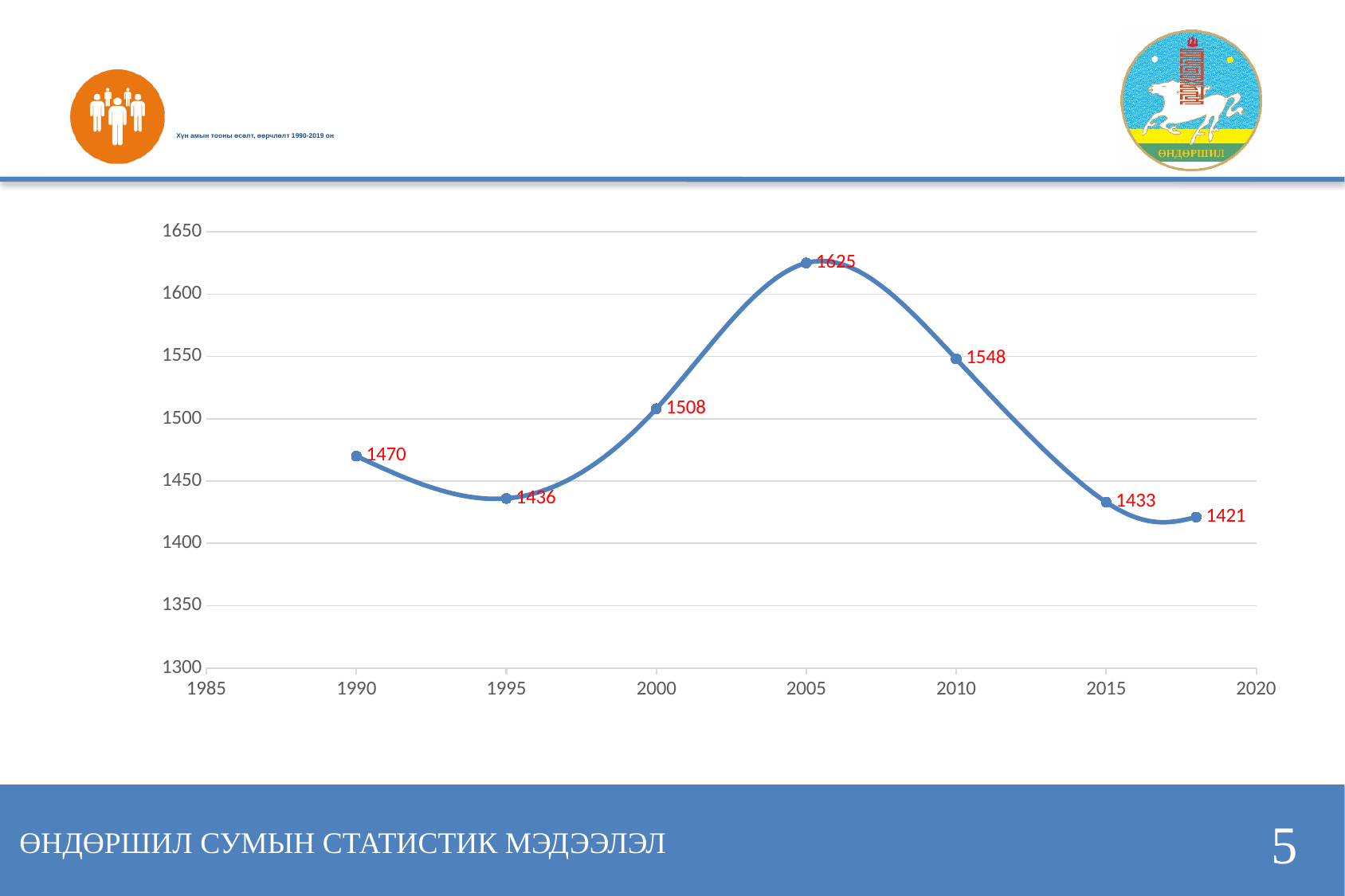
Does the line rise or fall between 2005 and 2015? fall What is the difference between the values for 2010 and 2015? 115 In which year does the line reach its highest value? 2005 What type of chart is shown on the slide? line chart What is the value of the last data point on the line? 1421 What is the lowest value labelled on the line? 1421 What is the value plotted for 2015? 1433 What is the value plotted for 1990? 1470 What is the value plotted for 2005? 1625 What is the difference between the values for 2005 and 1990? 155 How many data points are plotted on the line? 7 Which year has the larger value, 1995 or 2000? 2000